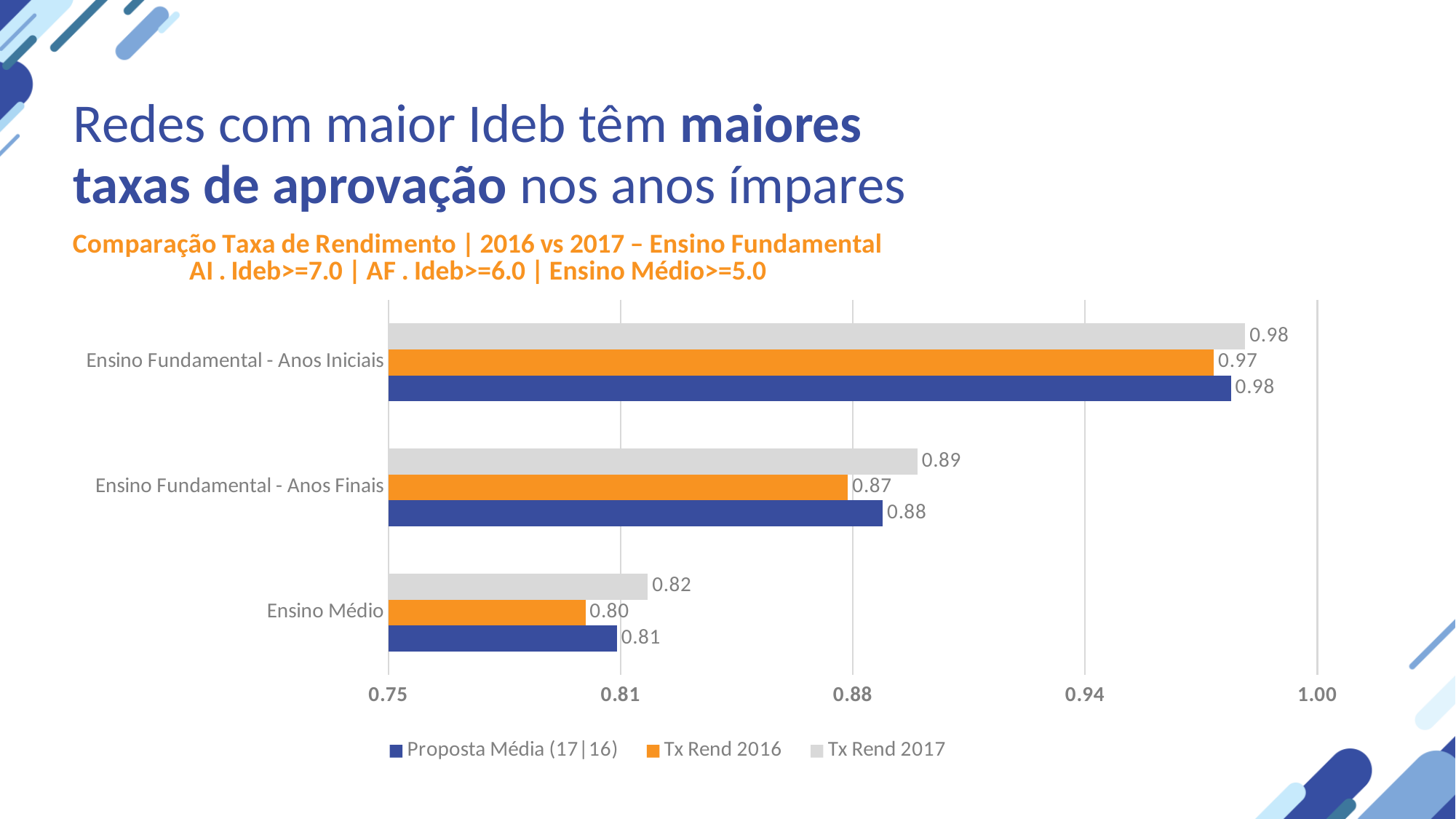
Which category has the highest Tx Rend 2016 value? Ensino Fundamental - Anos Iniciais How many series does the legend list? 3 What is the Proposta Média (17|16) value for Ensino Fundamental - Anos Iniciais? 0.98 Which colour represents the Tx Rend 2016 series? Orange For Ensino Médio, which is larger: Tx Rend 2017 or Proposta Média (17|16)? Tx Rend 2017 What is the difference between the Tx Rend 2017 and Tx Rend 2016 values for Ensino Fundamental - Anos Finais? 0.02 How many categories are shown on the chart? 3 Which category has the lowest Tx Rend 2017 value? Ensino Médio What is the Tx Rend 2016 value for Ensino Médio? 0.80 Is the Tx Rend 2016 value for Ensino Fundamental - Anos Finais greater or less than 0.81? greater What kind of chart is shown on the slide? Bar chart What is the Tx Rend 2017 value for Ensino Fundamental - Anos Finais? 0.89